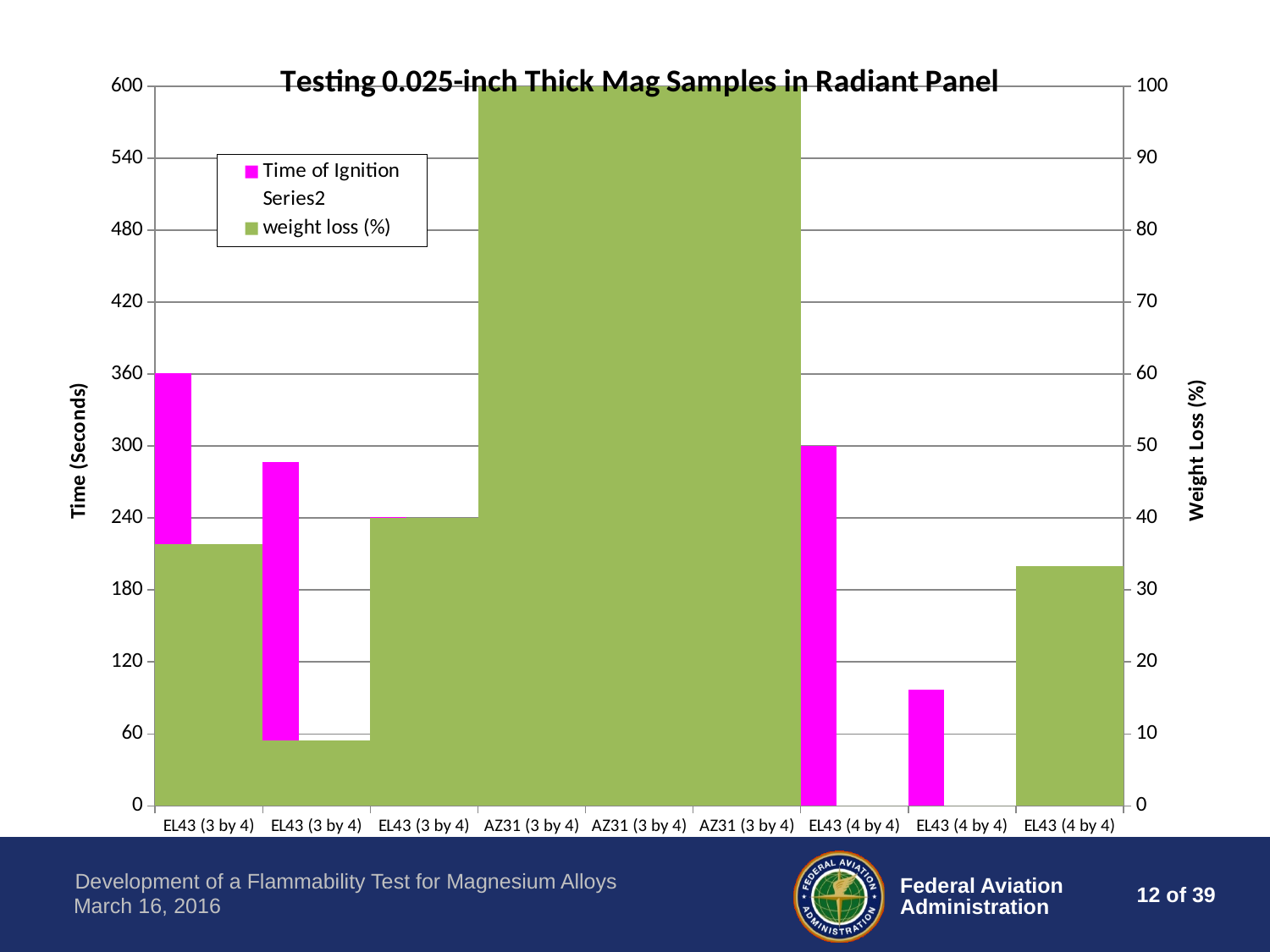
What is the label of the right-hand vertical axis? Weight Loss (%) How many series does the chart's legend list? 3 Is the Time of Ignition for the eighth category from the left (the second EL43 (4 by 4)) greater or less than 120? less Is the Time of Ignition for the second category from the left (the second EL43 (3 by 4)) greater or less than 240? greater What is the title of the chart? Testing 0.025-inch Thick Mag Samples in Radiant Panel How many categories are shown along the x axis of the chart? 9 What is the Time of Ignition value for the seventh category from the left, the first EL43 (4 by 4)? 300 What kind of chart is shown on the slide? bar chart What is the weight loss (%) value for each of the three AZ31 (3 by 4) categories? 100 Which category has the highest Time of Ignition? the leftmost EL43 (3 by 4)